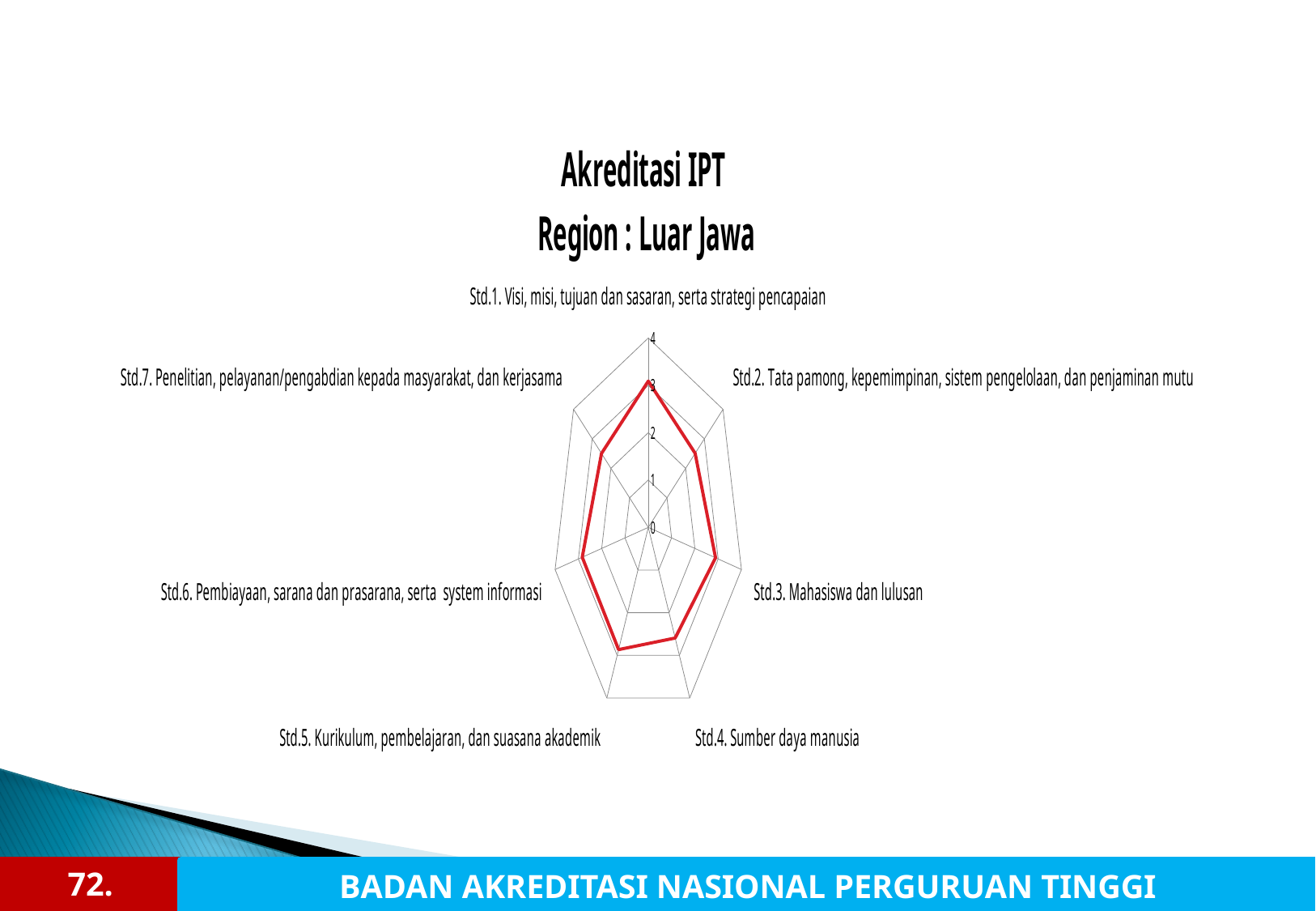
Is the value for Std.6 (Pembiayaan, sarana dan prasarana, serta system informasi) greater or less than 2? greater What is the title of the chart? Akreditasi IPT Region : Luar Jawa What is the highest value shown on the chart's axis scale? 4 How many standards (categories) are plotted on the radar chart? 7 Is the value for Std.7 (Penelitian, pelayanan/pengabdian kepada masyarakat, dan kerjasama) greater or less than 4? less Is the value for Std.1 (Visi, misi, tujuan dan sasaran, serta strategi pencapaian) greater or less than 2? greater Which region does the chart cover, according to its title? Luar Jawa What kind of chart is shown on the slide? Radar chart